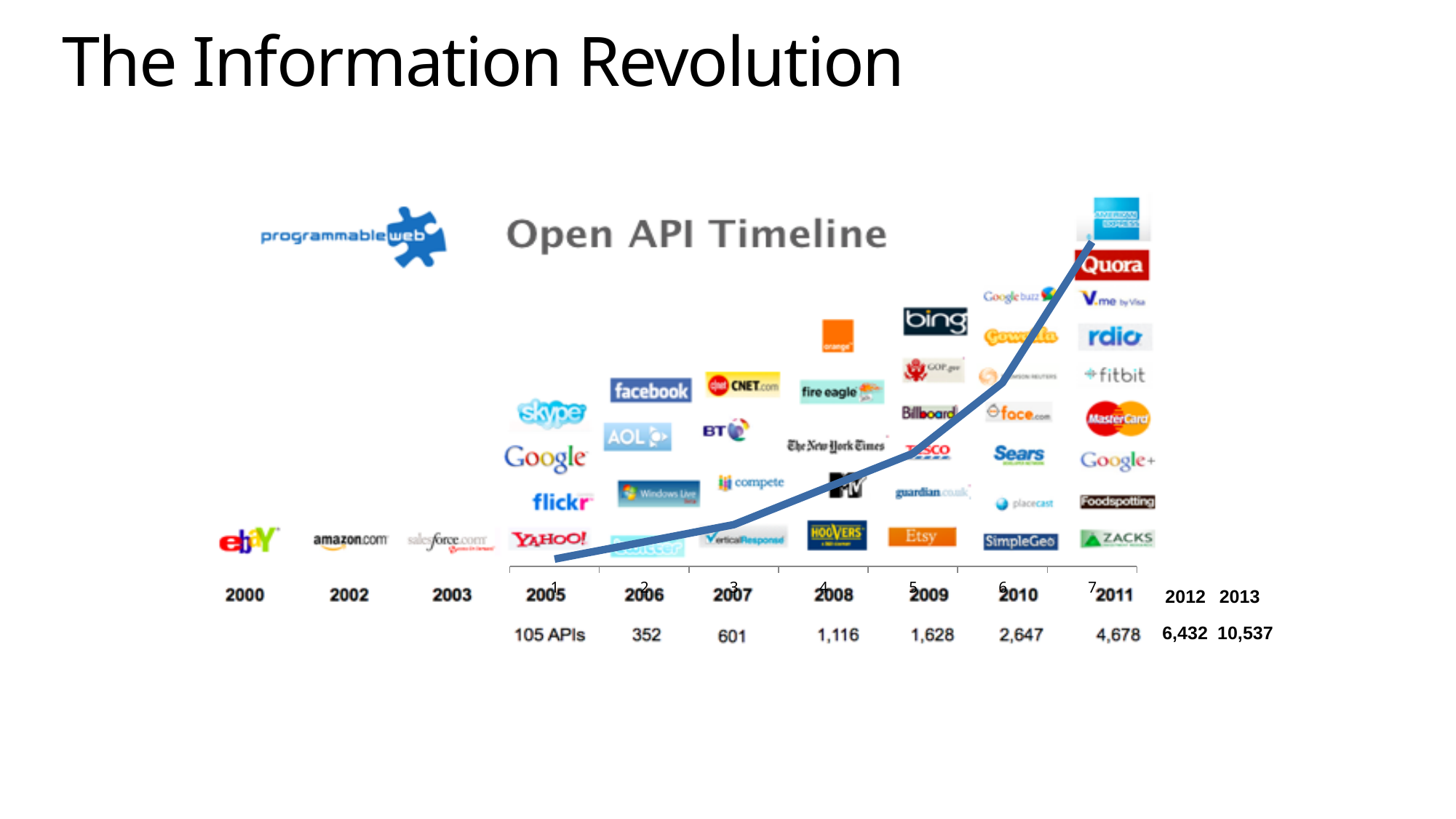
Which year has the lowest API count printed on the slide? 2005 What is the number of APIs printed for 2005? 105 APIs Which year has the highest API count printed on the slide? 2013 What is the number of APIs printed for 2008? 1,116 What is the number of APIs printed for 2013? 10,537 How many numbered tick marks does the line chart's x axis show? 7 What is the number of APIs printed for 2011? 4,678 What is the difference between the API counts for 2010 and 2009? 1,019 What kind of chart is overlaid on the Open API Timeline image? line chart Does the line rise or fall from 2005 to 2011? rises How many API count values are printed along the bottom of the timeline? 9 Which is larger, the API count for 2012 or for 2011? 2012